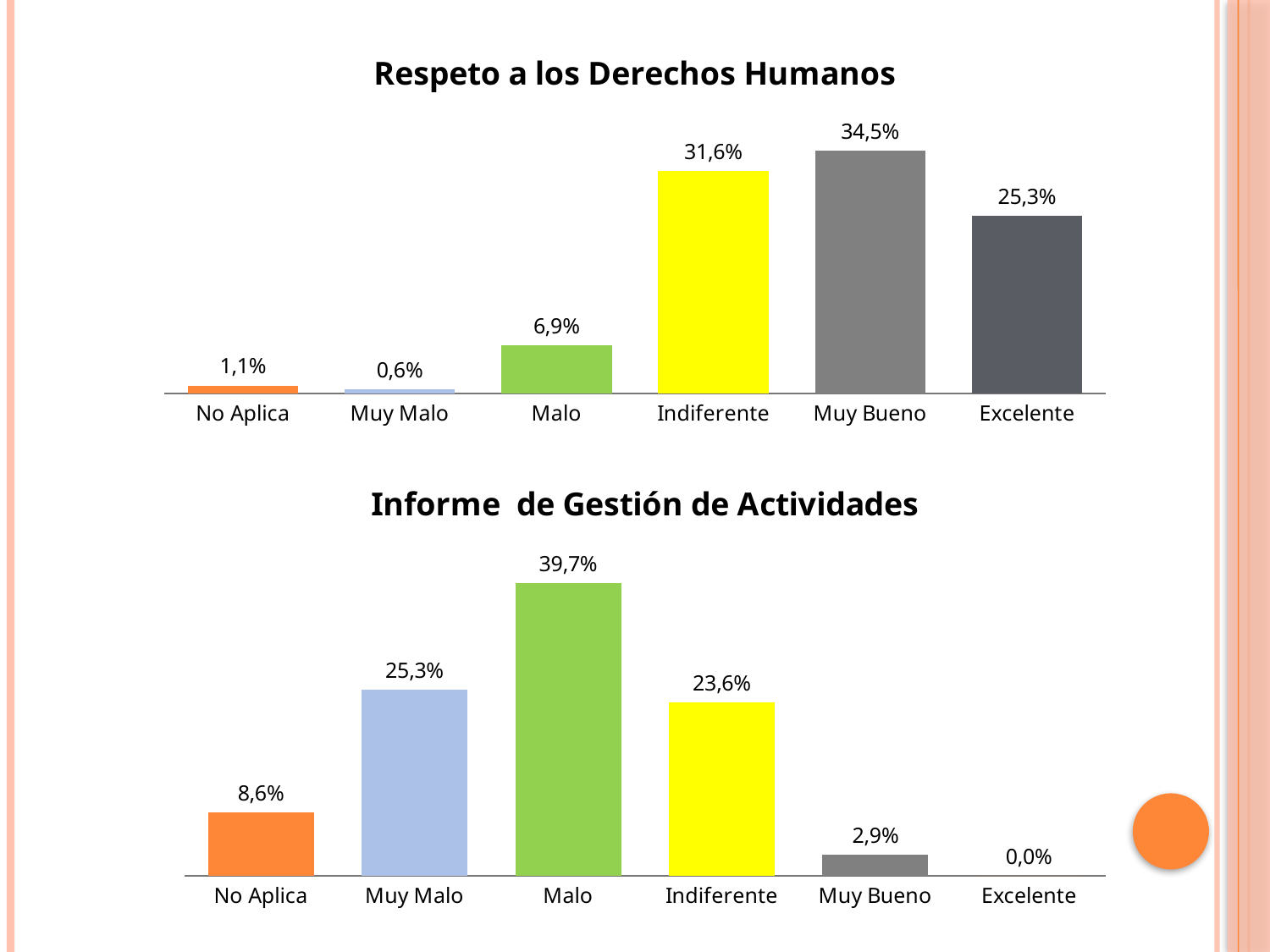
In the 'Informe de Gestión de Actividades' chart, what is the value for Malo? 39,7% In the 'Informe de Gestión de Actividades' chart, what is the value for Excelente? 0,0% In the 'Respeto a los Derechos Humanos' chart, what is the value for Muy Bueno? 34,5% How many categories are shown in the 'Respeto a los Derechos Humanos' chart? 6 In the 'Informe de Gestión de Actividades' chart, which category has the highest value? Malo What kind of chart is the 'Informe de Gestión de Actividades' chart? Bar chart In the 'Informe de Gestión de Actividades' chart, what is the difference between Malo and Indiferente? 16,1% In the 'Informe de Gestión de Actividades' chart, which is larger, Muy Malo or Indiferente? Muy Malo In the 'Respeto a los Derechos Humanos' chart, what is the value for Malo? 6,9% In the 'Respeto a los Derechos Humanos' chart, which category has the lowest value? Muy Malo In the 'Respeto a los Derechos Humanos' chart, what is the difference between Muy Bueno and Excelente? 9,2% In the 'Respeto a los Derechos Humanos' chart, which category has the highest value? Muy Bueno